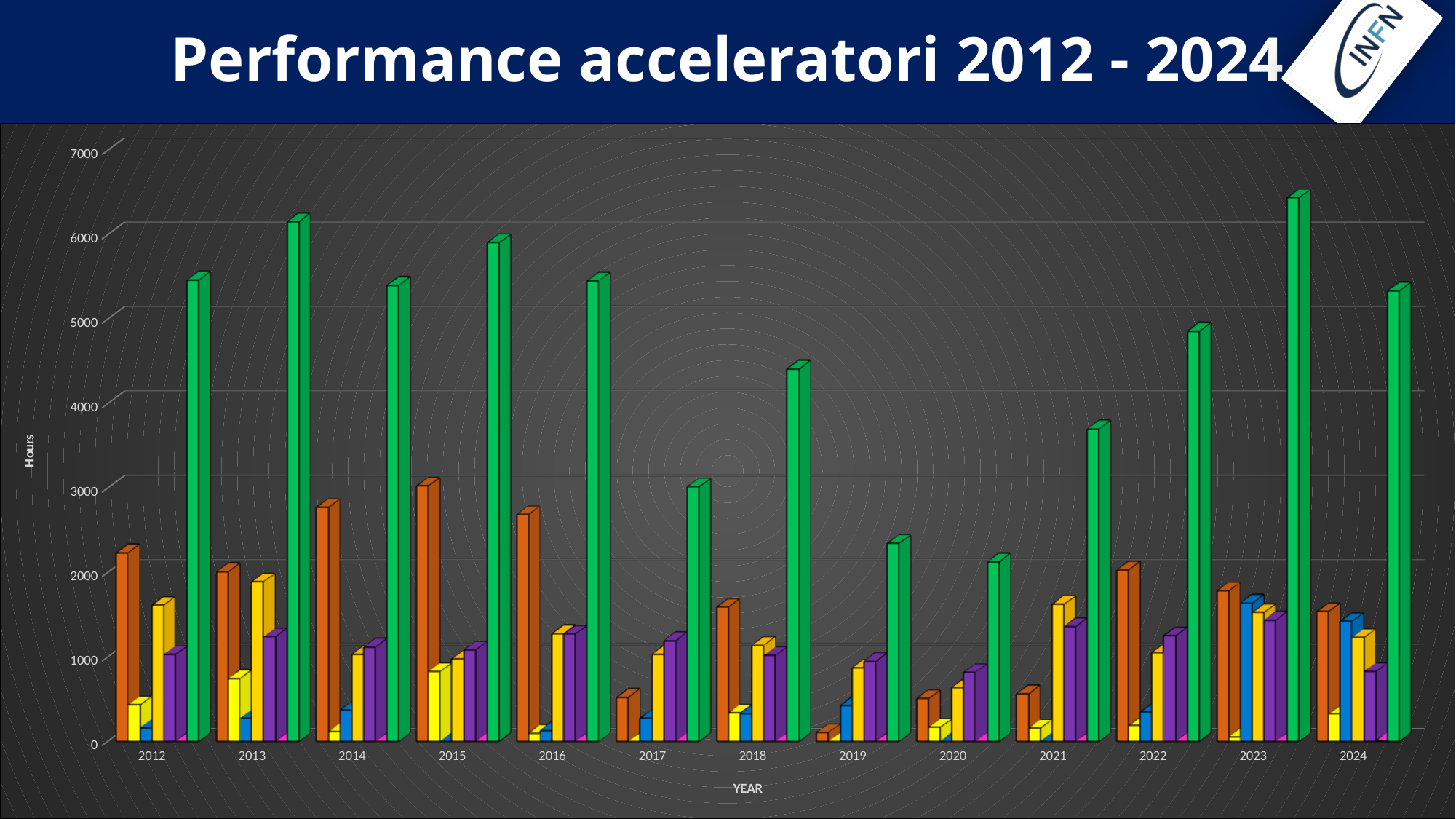
Which is taller, the green bar for 2013 or the green bar for 2017? 2013 What is the title of the slide's chart? Performance acceleratori 2012 - 2024 Is the orange bar for 2019 greater or less than 1000? less Is the green bar for 2021 greater or less than 4000? less What kind of chart is shown on the slide? bar chart What is the label on the vertical axis of the chart? Hours Do the green bars rise or fall from 2020 to 2023? rise In which year is the green bar the tallest? 2023 Is the green bar for 2020 greater or less than 3000? less How many years are shown along the x axis of the chart? 13